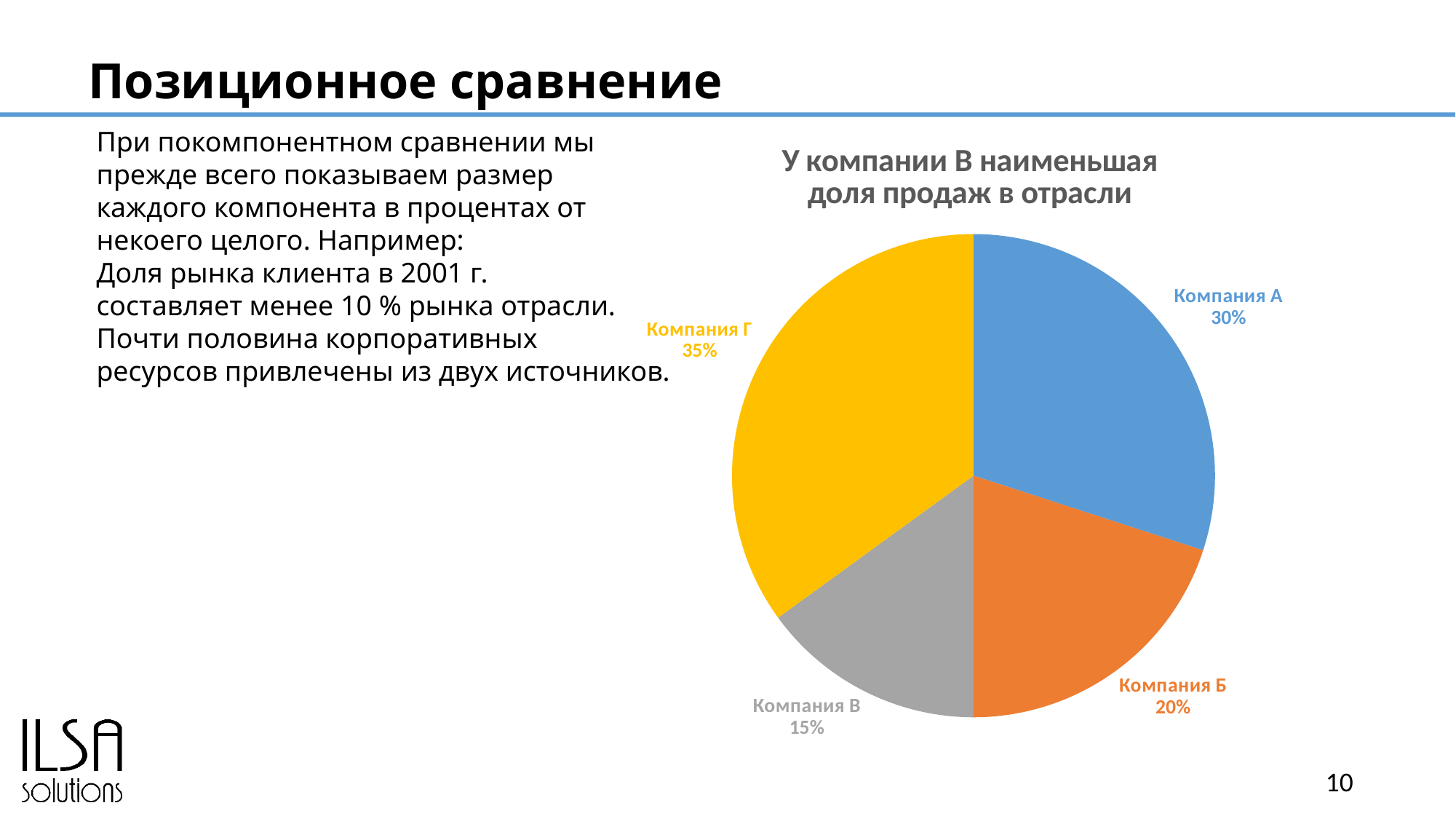
What is the title of the chart? У компании В наименьшая доля продаж в отрасли What share does Компания Г have in the pie chart? 35% Which company has the largest slice of the pie chart? Компания Г Which is larger, the share of Компания А or the share of Компания Б? Компания А Which company has the smallest slice of the pie chart? Компания В What colour is the slice for Компания Г? yellow What is the difference between the shares of Компания Г and Компания В? 20% How many companies are shown in the pie chart? 4 What share does Компания А have in the pie chart? 30% What type of chart is shown on the slide? pie chart What share does Компания В have in the pie chart? 15% What share does Компания Б have in the pie chart? 20%